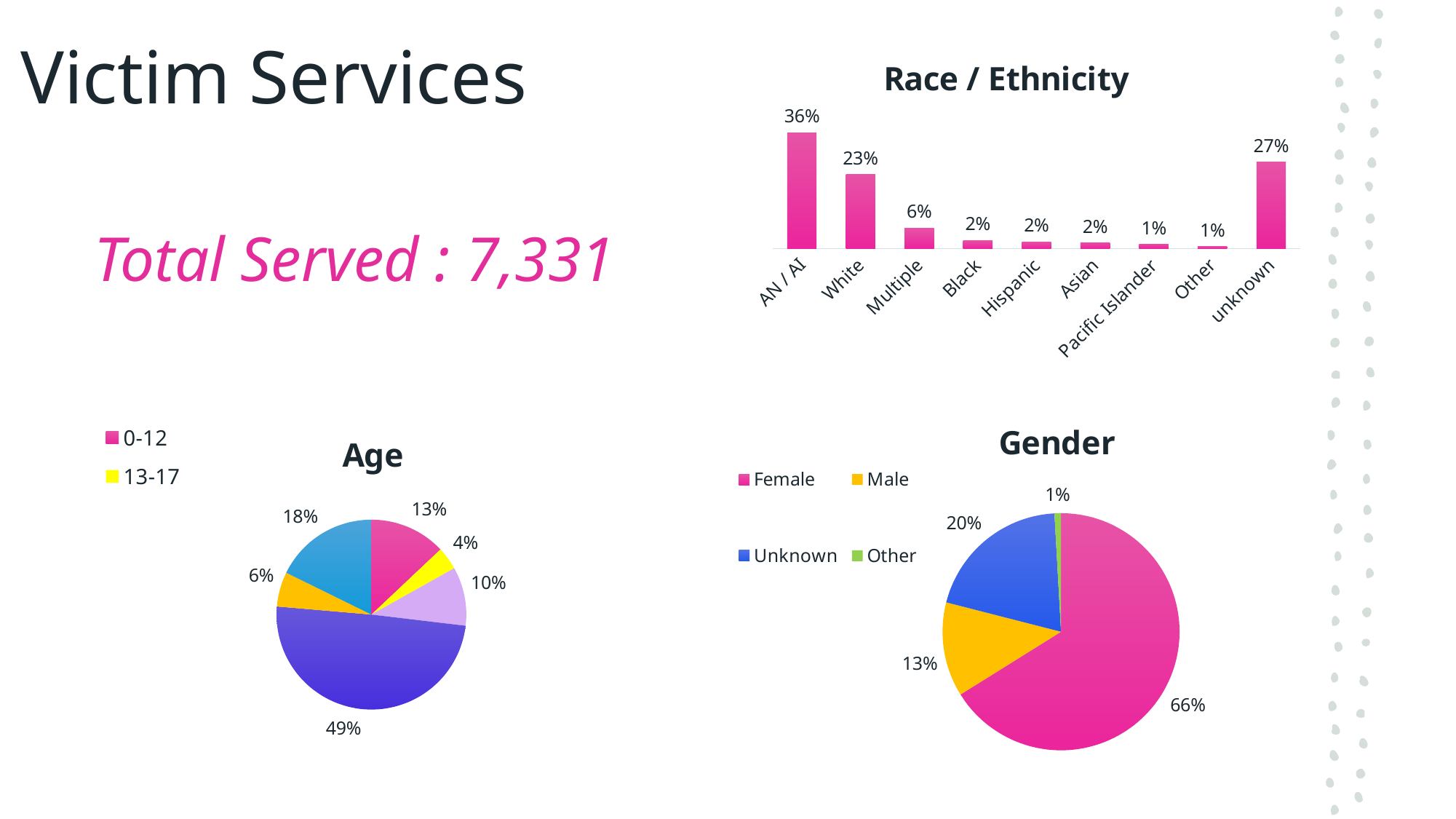
How many slices does the Age pie chart have? 6 How many entries does the legend of the Gender chart list? 4 How many categories are shown in the Race / Ethnicity chart? 9 In the Race / Ethnicity chart, which category has the highest value? AN / AI In the Gender chart, which category has the smallest share? Other In the Race / Ethnicity chart, which is larger, Multiple or Black? Multiple What kind of chart is the Race / Ethnicity chart? Bar chart In the Age chart, what is the value for 13-17? 4% In the Race / Ethnicity chart, what is the difference between AN / AI and unknown? 9% In the Gender chart, what share of the pie is Female? 66% In the Age chart, what share of the pie is the 0-12 slice? 13% In the Race / Ethnicity chart, what is the value for White? 23%